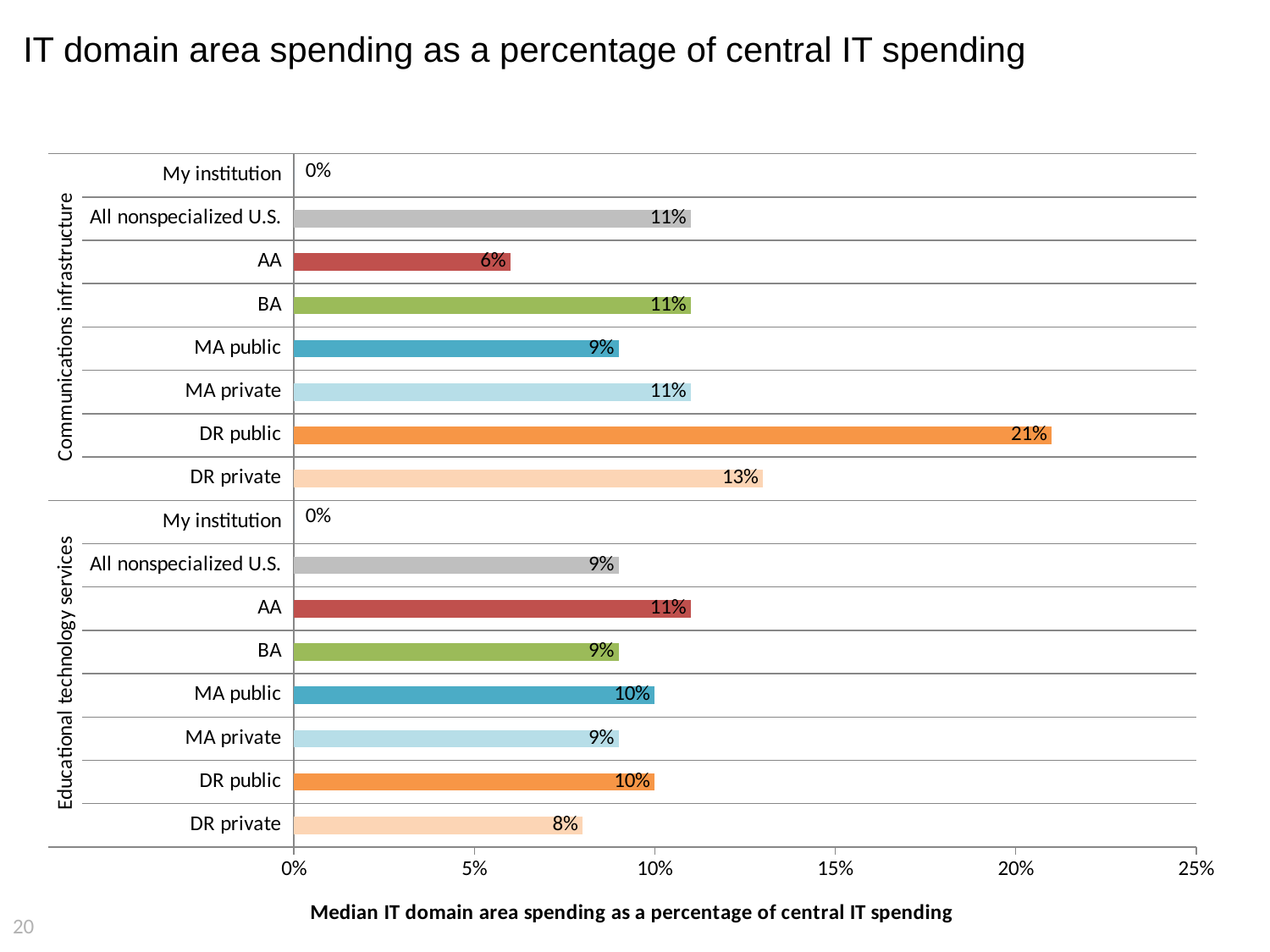
Excluding My institution, which category has the lowest value under Communications infrastructure? AA What is the difference between DR public and DR private under Communications infrastructure? 8% How many bars are plotted under the Educational technology services group? 8 Which category has the highest value under Communications infrastructure? DR public What kind of chart is shown on the slide? bar chart What is the value for AA under Educational technology services? 11% What is the value for DR private under Educational technology services? 8% Is the value for DR public under Communications infrastructure greater or less than 20%? greater What is the value for DR public under Communications infrastructure? 21% What is the x-axis title of the chart? Median IT domain area spending as a percentage of central IT spending Which is larger under Educational technology services: MA public or DR private? MA public What is the value for All nonspecialized U.S. under Communications infrastructure? 11%